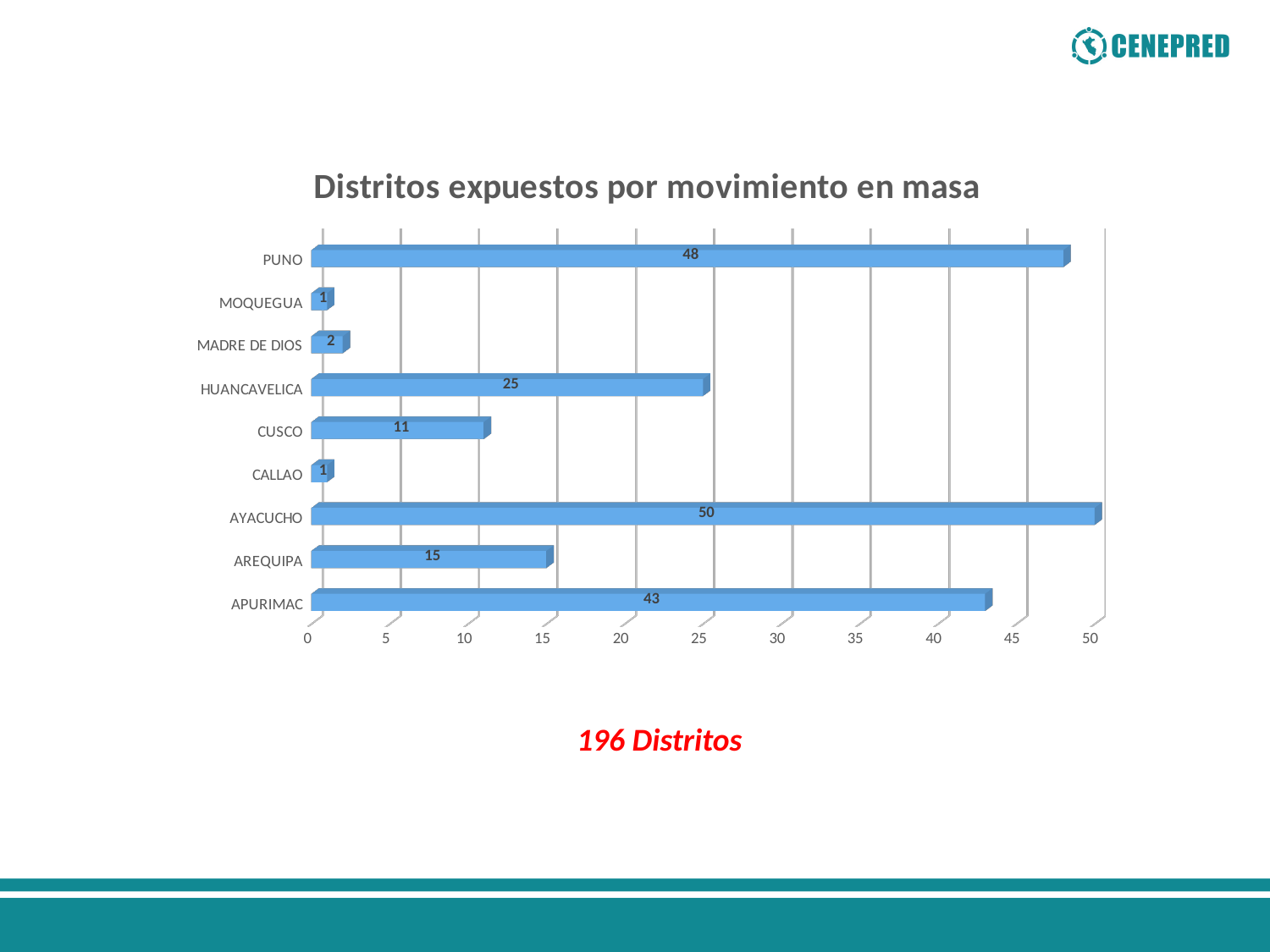
What is the title of the chart? Distritos expuestos por movimiento en masa Which is larger, the value for CUSCO or the value for AREQUIPA? AREQUIPA What is the difference between the values for PUNO and HUANCAVELICA? 23 Is the value for APURIMAC greater or less than 40? greater Which category has the highest value? AYACUCHO What kind of chart is shown on the slide? bar chart What is the value for PUNO? 48 What is the difference between the values for AYACUCHO and APURIMAC? 7 What is the value for AREQUIPA? 15 What is the value for HUANCAVELICA? 25 How many categories are shown in the chart? 9 What is the value for MADRE DE DIOS? 2